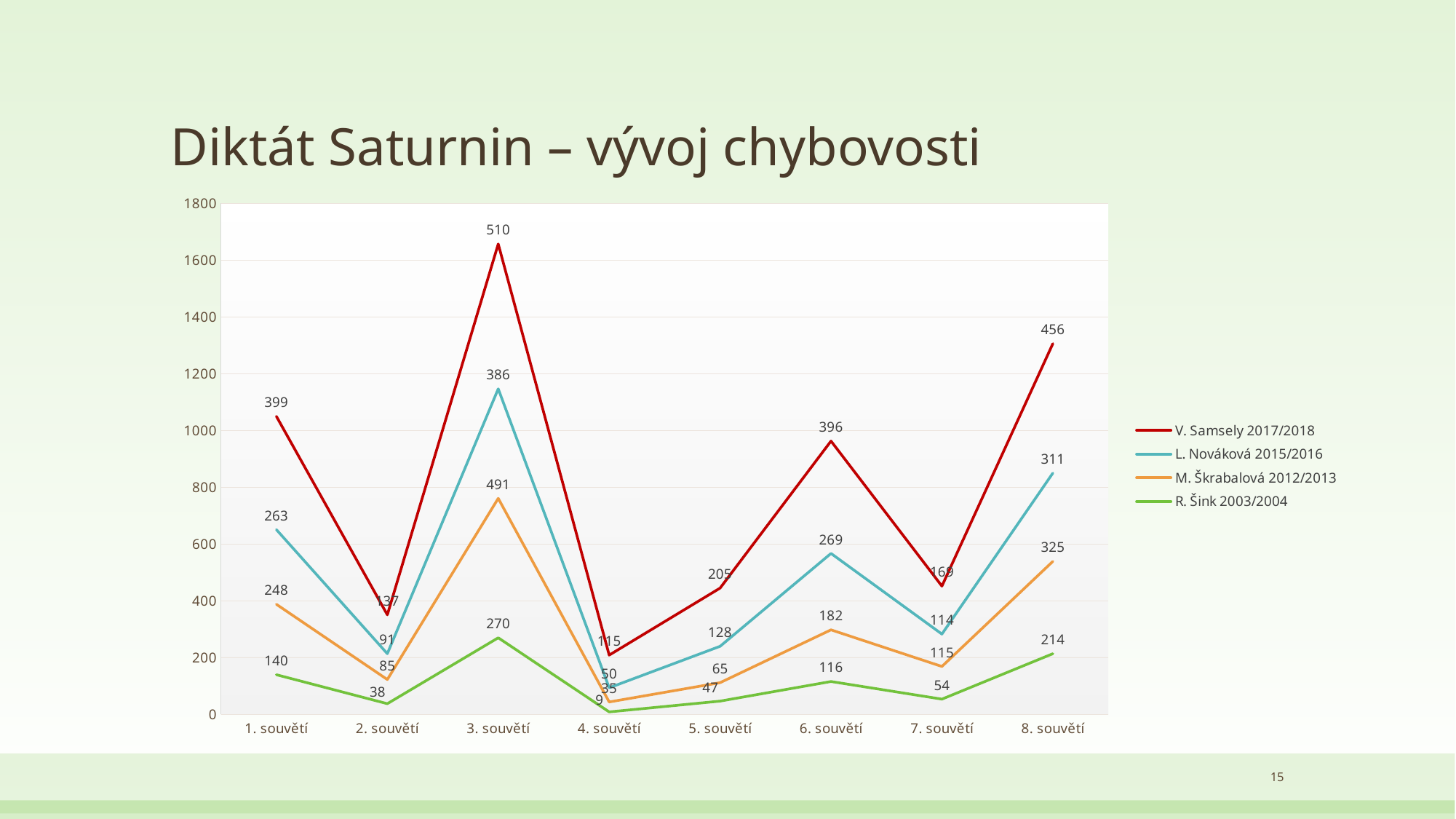
How many series does the legend list? 4 At 6. souvětí, which has the larger labelled value: L. Nováková 2015/2016 or M. Škrabalová 2012/2013? L. Nováková 2015/2016 What is the data label for R. Šink 2003/2004 at 4. souvětí? 9 What is the data label for M. Škrabalová 2012/2013 at 8. souvětí? 325 What kind of chart is shown on the slide? Line chart What is the data label for V. Samsely 2017/2018 at 3. souvětí? 510 How many categories are shown on the x axis? 8 What is the title of the slide? Diktát Saturnin – vývoj chybovosti What is the difference between the V. Samsely 2017/2018 labels at 3. souvětí and 8. souvětí? 54 What colour is the line for R. Šink 2003/2004? Green At which category does L. Nováková 2015/2016 have its lowest labelled value? 4. souvětí At which category does R. Šink 2003/2004 have its highest labelled value? 3. souvětí